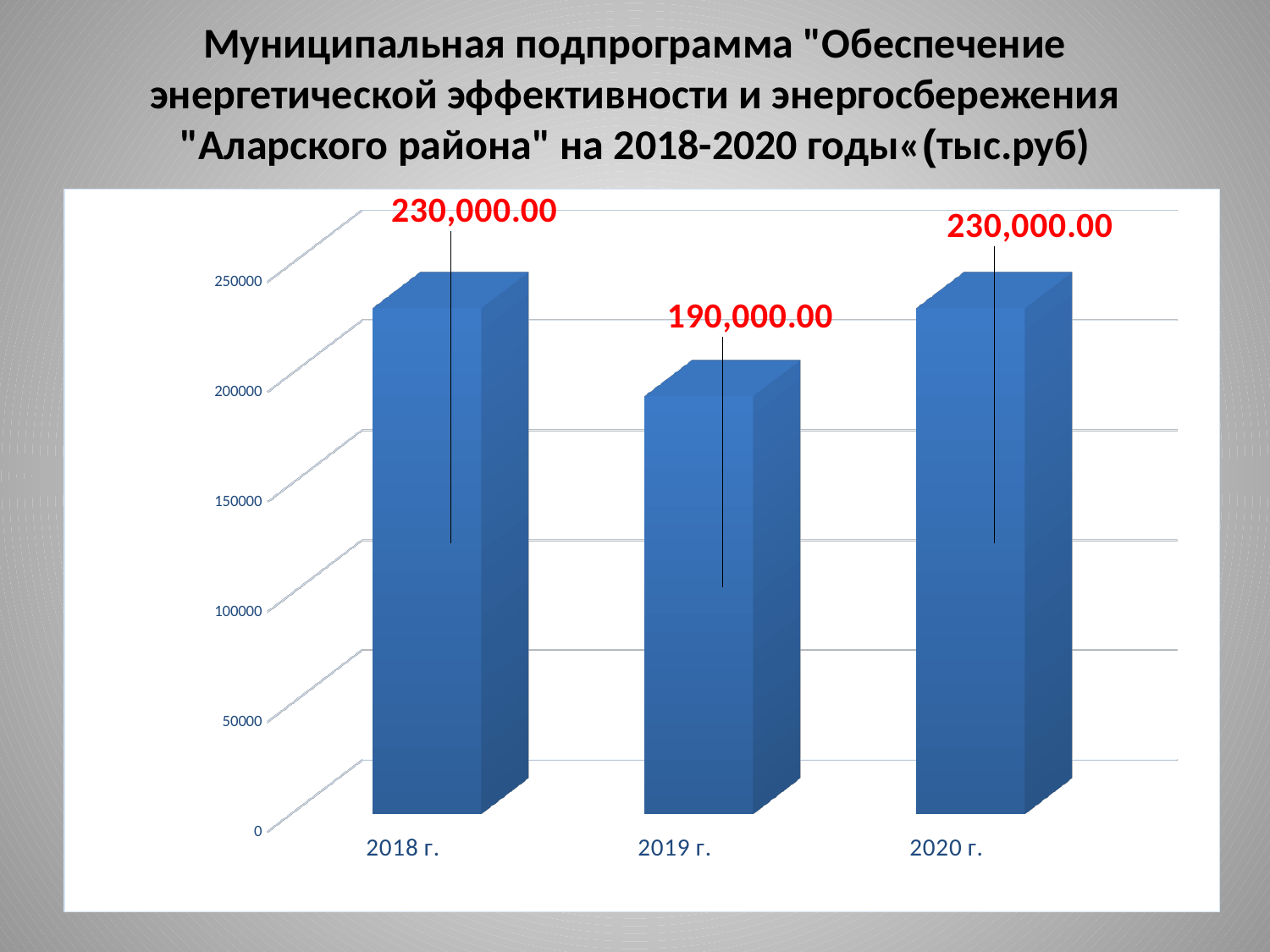
Does the value fall or rise from 2019 г. to 2020 г.? rise What is the difference between the values for 2018 г. and 2019 г.? 40,000.00 Is the value for 2019 г. greater or less than 200000? less Which is larger, the value for 2019 г. or the value for 2020 г.? 2020 г. What is the value for 2020 г.? 230,000.00 What kind of chart is shown on the slide? bar chart Is the value for 2020 г. greater or less than 200000? greater What is the value for 2019 г.? 190,000.00 What unit is given in parentheses at the end of the slide title? тыс.руб How many years are shown on the x axis? 3 What is the value for 2018 г.? 230,000.00 Which year has the lowest value? 2019 г.